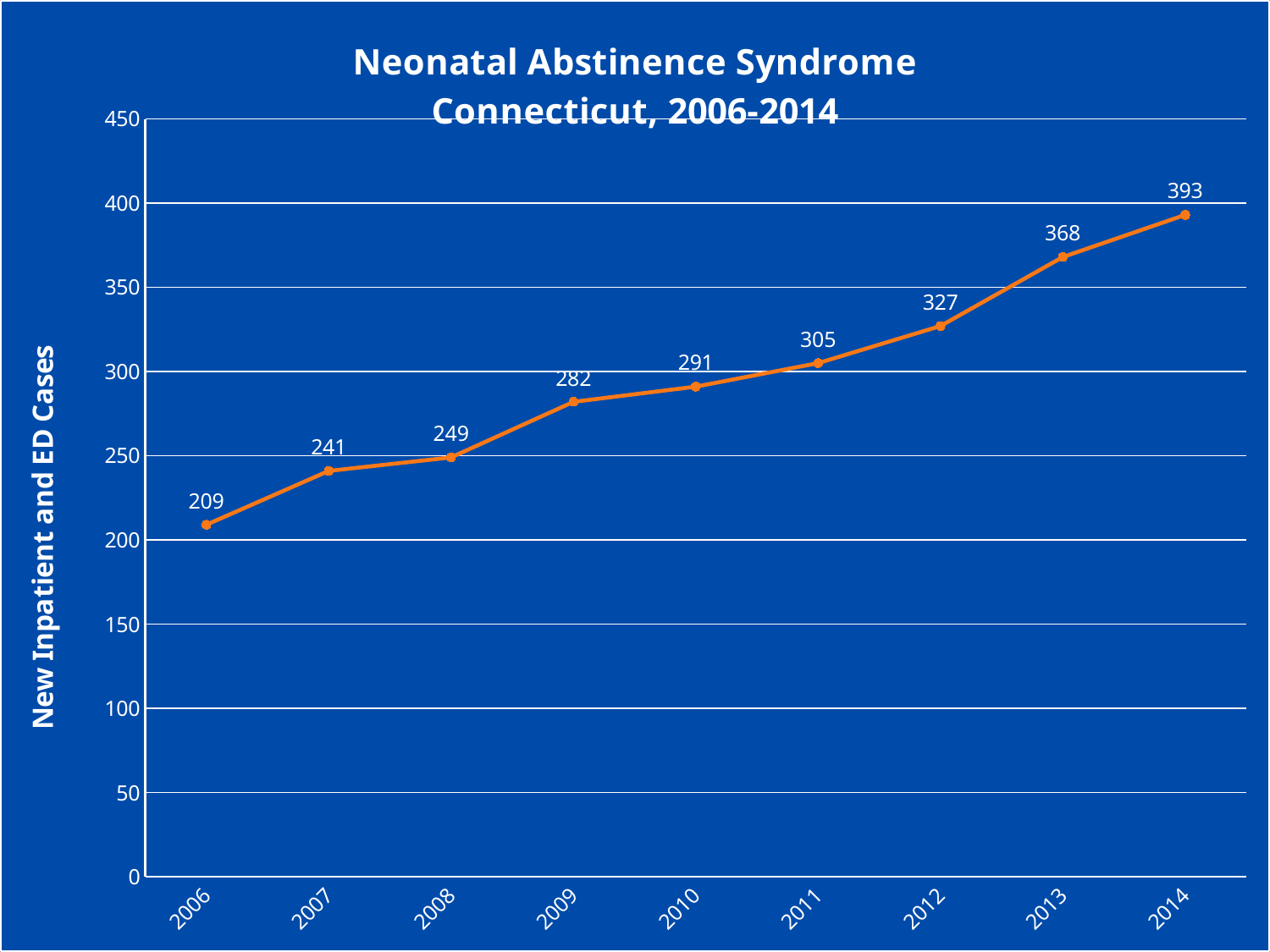
Do the values rise or fall from 2006 to 2014? rise Which year has the highest number of cases? 2014 What kind of chart is shown on the slide? line chart How many years are plotted on the chart? 9 Is the value for 2012 greater or less than 300? greater What is the number of new inpatient and ED cases in 2014? 393 What is the number of new inpatient and ED cases in 2006? 209 Which year has the lowest number of cases? 2006 Which year has more cases, 2009 or 2010? 2010 What is the difference in cases between 2013 and 2012? 41 What is the number of new inpatient and ED cases in 2011? 305 What is the difference in cases between 2014 and 2006? 184